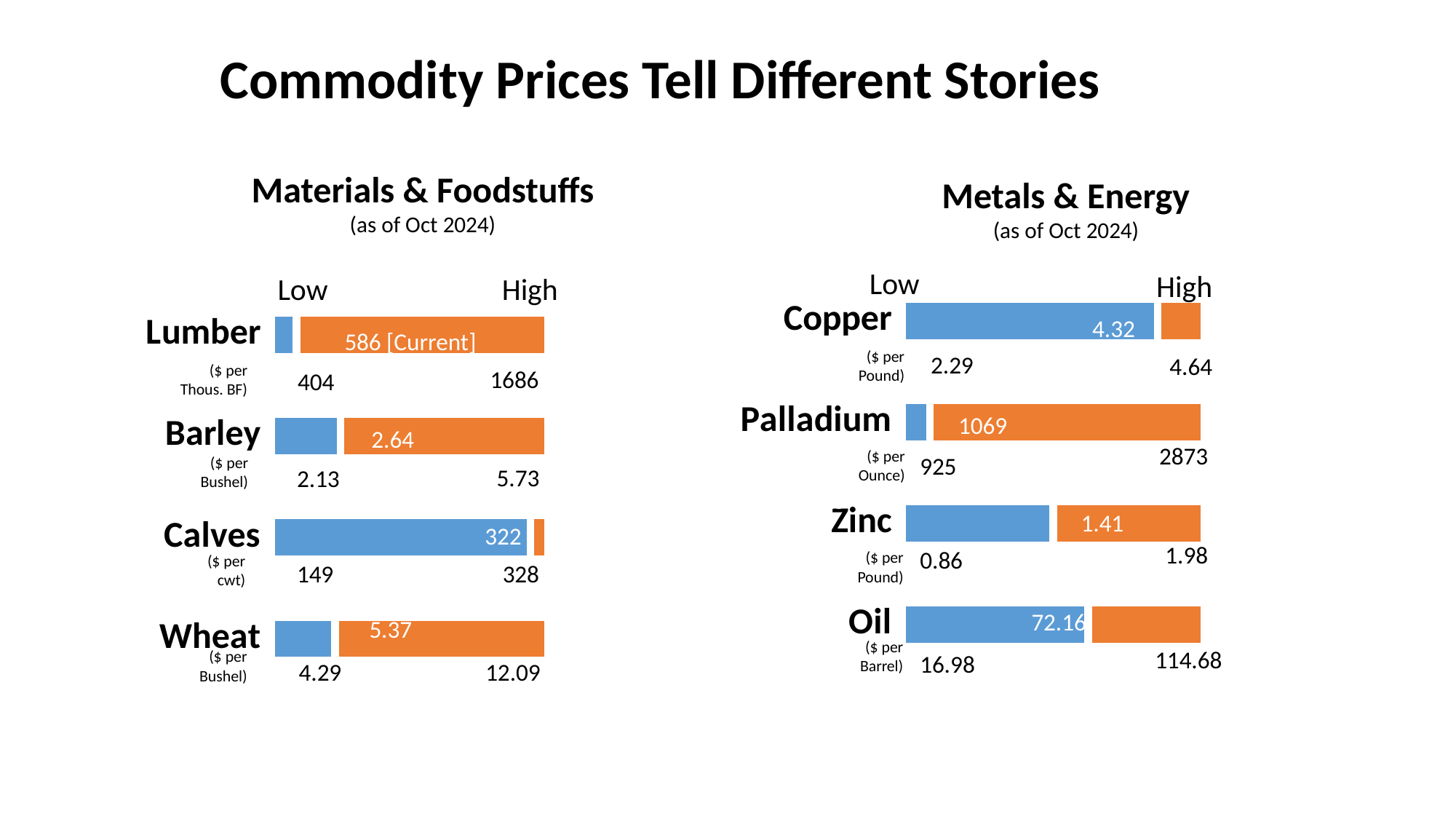
How many commodities are shown in the Metals & Energy chart? 4 In the Metals & Energy chart, what is the difference between the high price and the current price of Copper? 0.32 In the Metals & Energy chart, what is the low price shown for Zinc? 0.86 In the Materials & Foodstuffs chart, what is the high price shown for Wheat? 12.09 In the Materials & Foodstuffs chart, what is the difference between the high and low prices for Calves? 179 In the Metals & Energy chart, what is the current price of Oil? 72.16 What is the title of the slide? Commodity Prices Tell Different Stories In the Materials & Foodstuffs chart, which is larger: the current price of Barley or the current price of Wheat? Wheat In the Materials & Foodstuffs chart, what is the low price shown for Calves? 149 In the Metals & Energy chart, what is the high price shown for Palladium? 2873 In the Materials & Foodstuffs chart, what is the current price of Lumber? 586 What kind of chart is the Materials & Foodstuffs chart? Bar chart